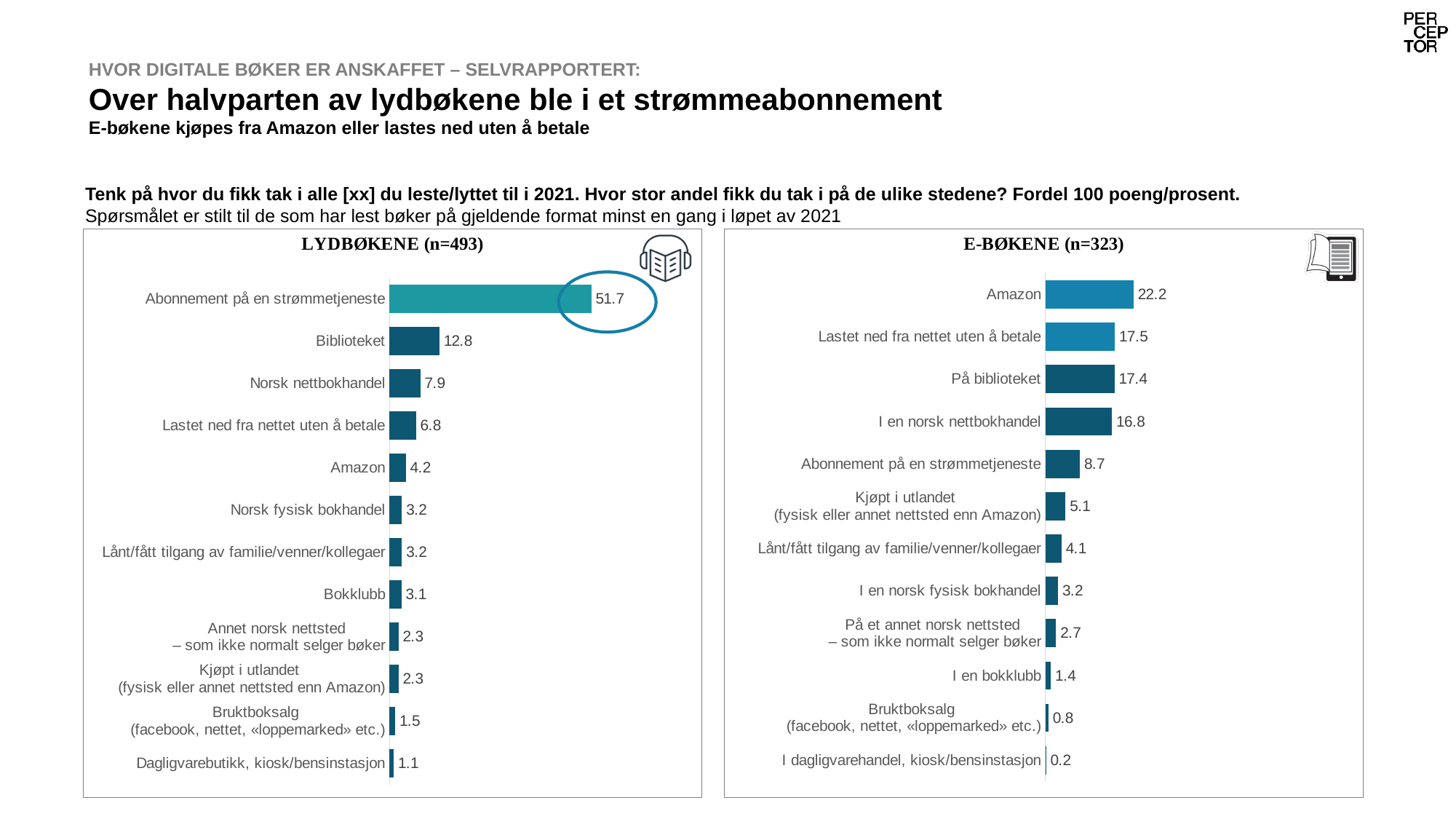
What kind of chart is the E-BØKENE (n=323) chart? Bar chart In the E-BØKENE (n=323) chart, which category has the lowest value? I dagligvarehandel, kiosk/bensinstasjon In the E-BØKENE (n=323) chart, what is the difference between Amazon and Lastet ned fra nettet uten å betale? 4.7 In the LYDBØKENE (n=493) chart, which category has the highest value? Abonnement på en strømmetjeneste In the LYDBØKENE (n=493) chart, which is larger: Norsk nettbokhandel or Amazon? Norsk nettbokhandel In the LYDBØKENE (n=493) chart, what is the value for Biblioteket? 12.8 How many categories are shown in the LYDBØKENE (n=493) chart? 12 In the E-BØKENE (n=323) chart, what is the value for Amazon? 22.2 In the LYDBØKENE (n=493) chart, what is the difference between Abonnement på en strømmetjeneste and Biblioteket? 38.9 In the LYDBØKENE (n=493) chart, what is the value for Dagligvarebutikk, kiosk/bensinstasjon? 1.1 In the E-BØKENE (n=323) chart, which is larger: Abonnement på en strømmetjeneste or Kjøpt i utlandet (fysisk eller annet nettsted enn Amazon)? Abonnement på en strømmetjeneste How many categories are shown in the E-BØKENE (n=323) chart? 12